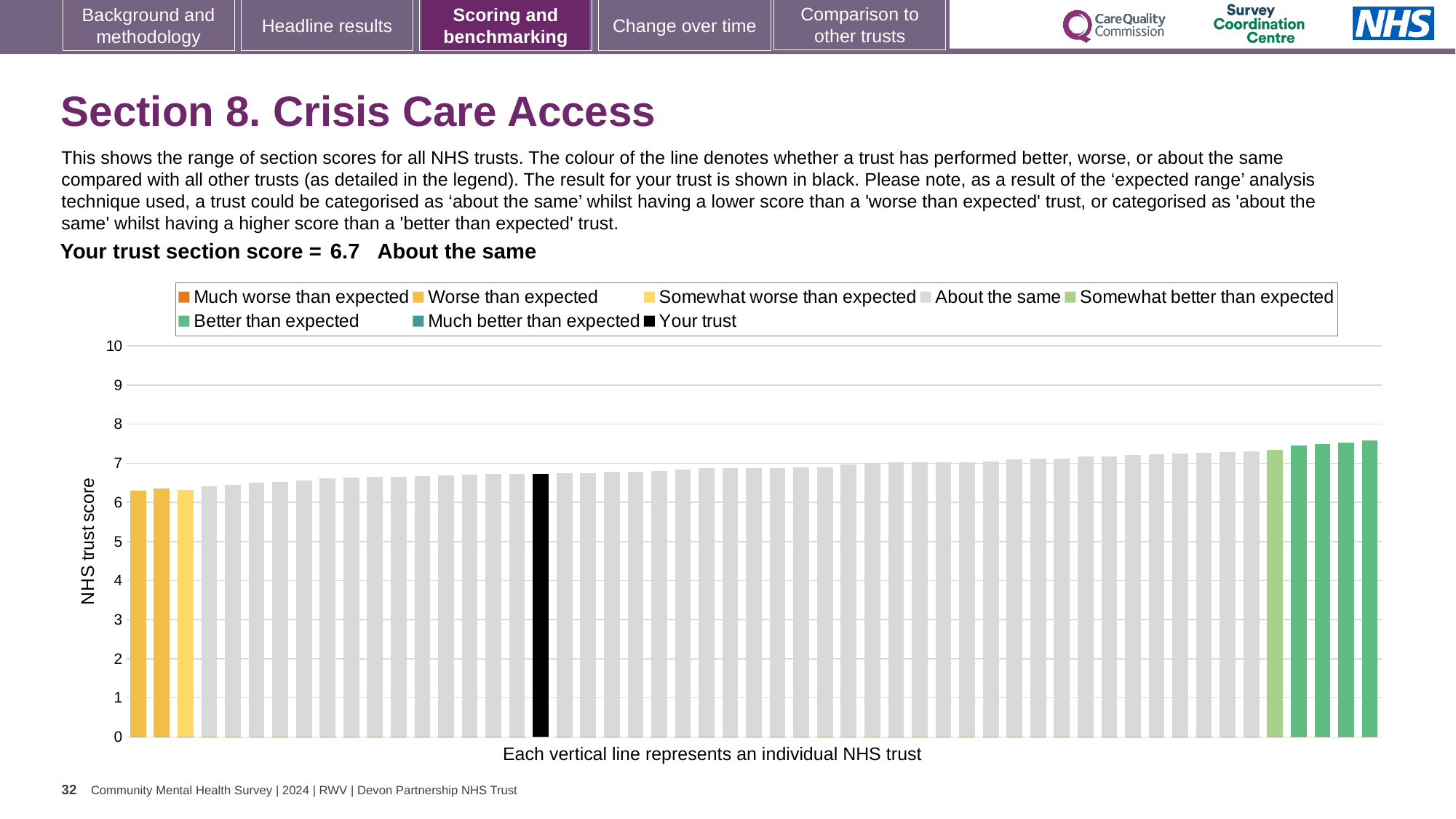
What kind of chart is shown on the slide? bar chart Which performance category is your trust placed in for this section? About the same How many bars are coloured in the 'Worse than expected' colour? 2 Is the value of the tallest bar on the chart greater or less than 8? less How many entries does the chart legend list? 8 Is the value of the black 'Your trust' bar greater or less than 7? less What is the label on the vertical axis of the chart? NHS trust score What is your trust's section score for Crisis Care Access? 6.7 Is the value of the black 'Your trust' bar greater or less than 6? greater How many bars are coloured in the 'Better than expected' colour? 4 Do the bar values rise or fall from left to right along the x axis? rise